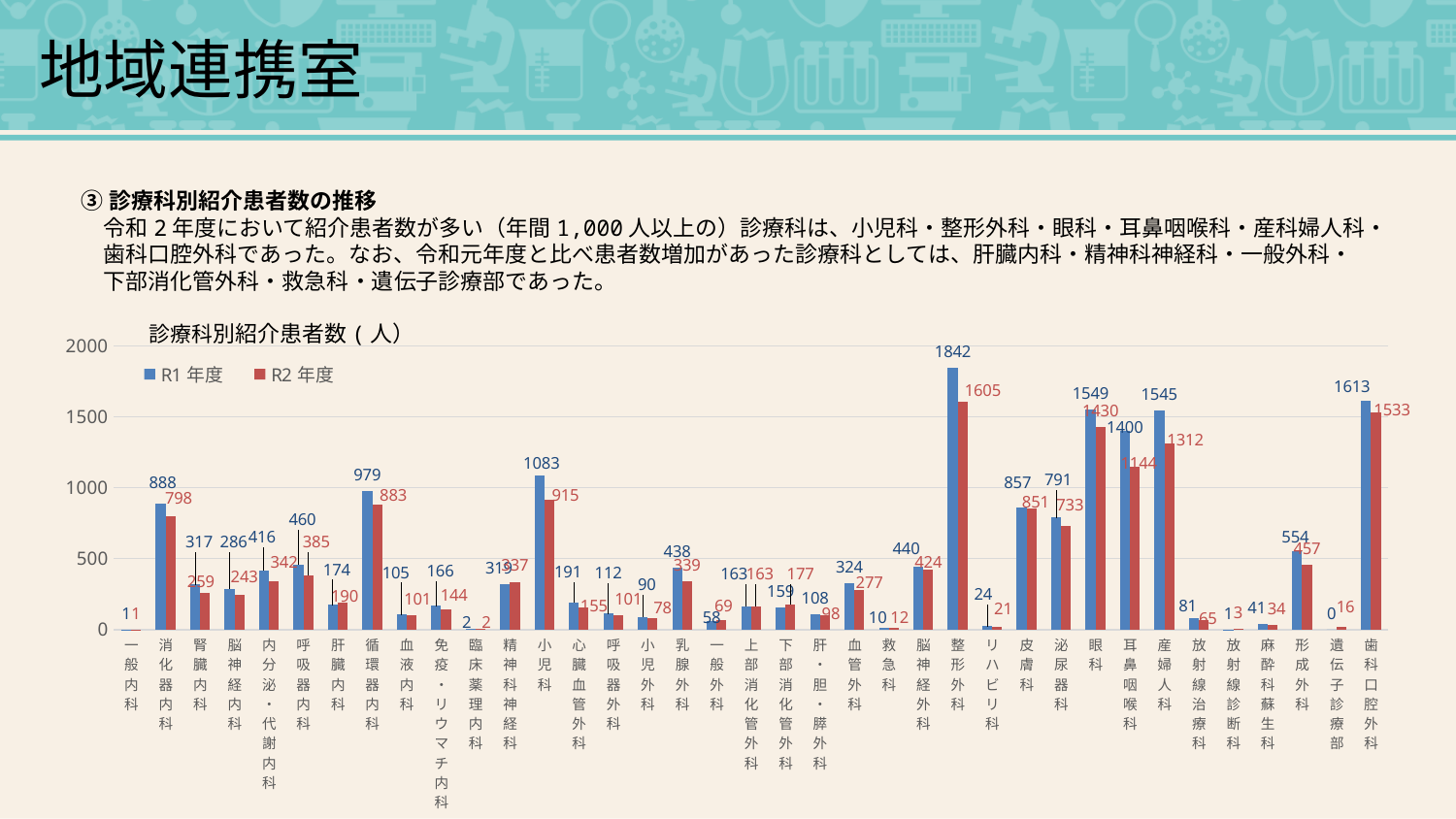
What is the title of the chart? 診療科別紹介患者数（人） What is the R2 年度 value for 歯科口腔外科? 1533 What is the R2 年度 value for 小児科? 915 Which colour represents R2 年度 in the chart? red Which is larger for 肝臓内科, the R1 年度 value or the R2 年度 value? R2 年度 Is the R2 年度 value for 耳鼻咽喉科 greater or less than 1000? greater What is the R1 年度 value for 整形外科? 1842 What is the R1 年度 value for 循環器内科? 979 What is the difference between the R1 年度 and R2 年度 values for 眼科? 119 What type of chart is shown on the slide? bar chart How many series does the legend list? 2 Which department has the highest R1 年度 value? 整形外科